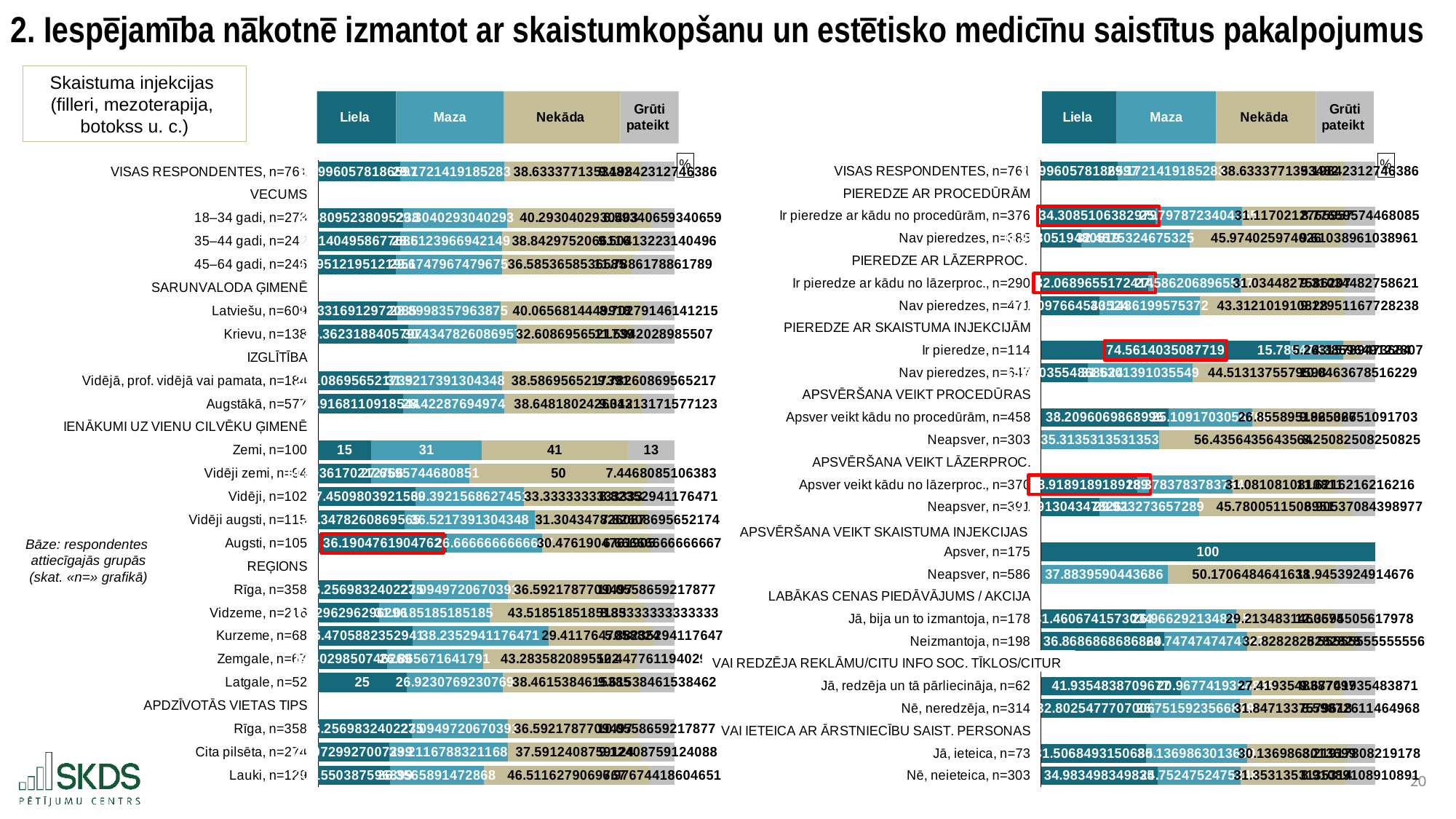
In the left chart, what is the total of the stacked bar for 'Zemi, n=100'? 100 In the left chart, what is the 'Liela' value for 'Zemi, n=100'? 15 In the left chart, what is the 'Grūti pateikt' value for 'Zemi, n=100'? 13 In the right chart, what is the 'Liela' value for 'Apsver, n=175'? 100 In the left chart, what is the 'Liela' value for 'Latgale, n=52'? 25 How many series does the legend of the left chart list? 4 In the left chart, what is the 'Nekāda' value for 'Vidēji zemi, n=94'? 50 In the left chart, for 'Zemi, n=100', which is larger: the 'Maza' value or the 'Nekāda' value? Nekāda In the left chart, what is the difference between the 'Nekāda' and 'Liela' values for 'Zemi, n=100'? 26 What kind of chart is the left chart? Stacked bar chart In the left chart, what is the 'Nekāda' value for 'Zemi, n=100'? 41